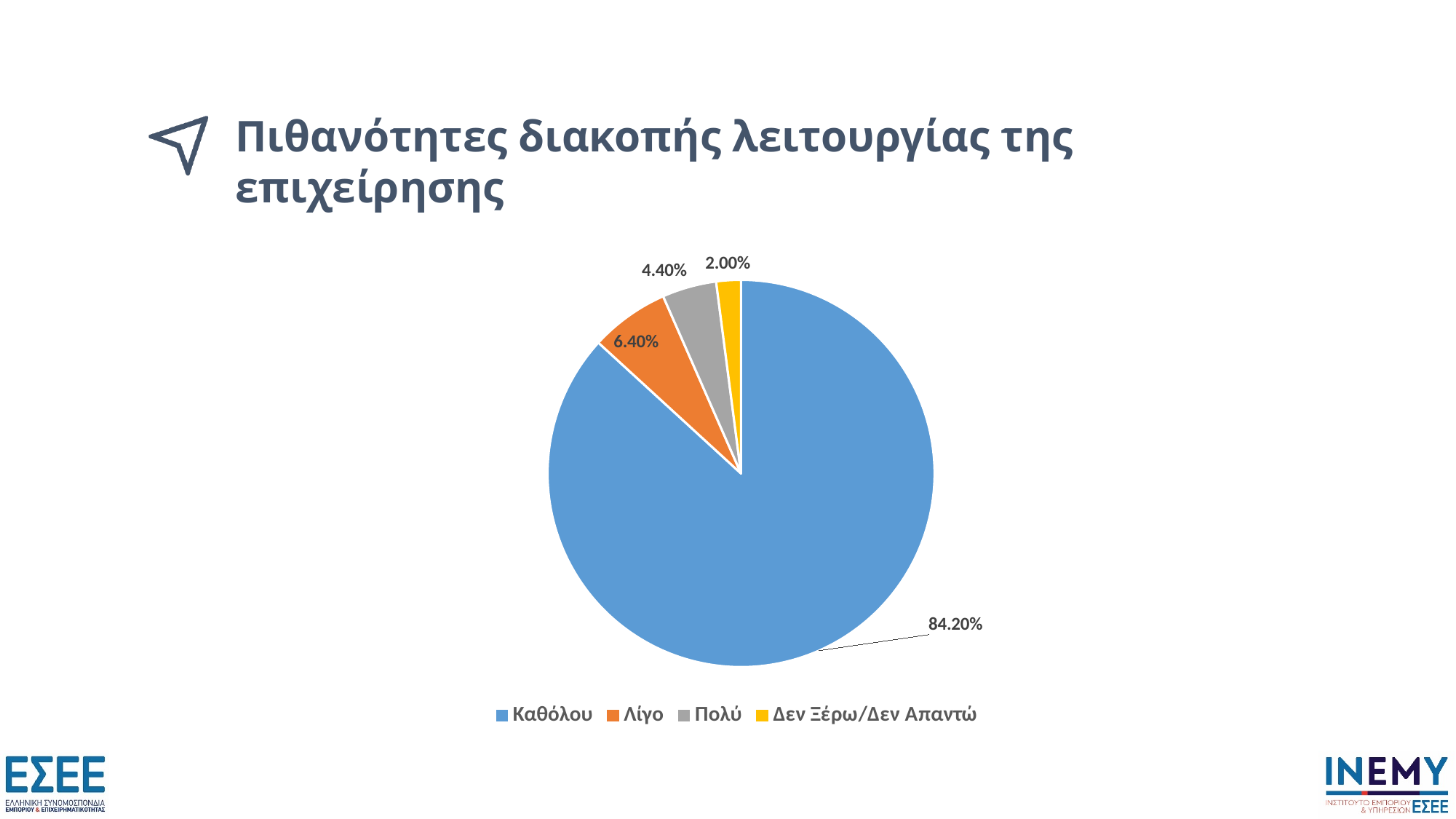
What percentage is shown for Λίγο? 6.40% Which category has the smallest slice of the pie? Δεν Ξέρω/Δεν Απαντώ What is the difference between the percentages for Λίγο and Πολύ? 2.00% What percentage is shown for Πολύ? 4.40% Which category has the largest slice of the pie? Καθόλου What colour is the slice for Λίγο? orange What type of chart is shown on the slide? pie chart Which is larger, the slice for Πολύ or the slice for Δεν Ξέρω/Δεν Απαντώ? Πολύ What is the combined percentage of Λίγο and Πολύ? 10.80% What percentage is shown for Καθόλου? 84.20% What percentage is shown for Δεν Ξέρω/Δεν Απαντώ? 2.00% How many categories does the pie chart show? 4